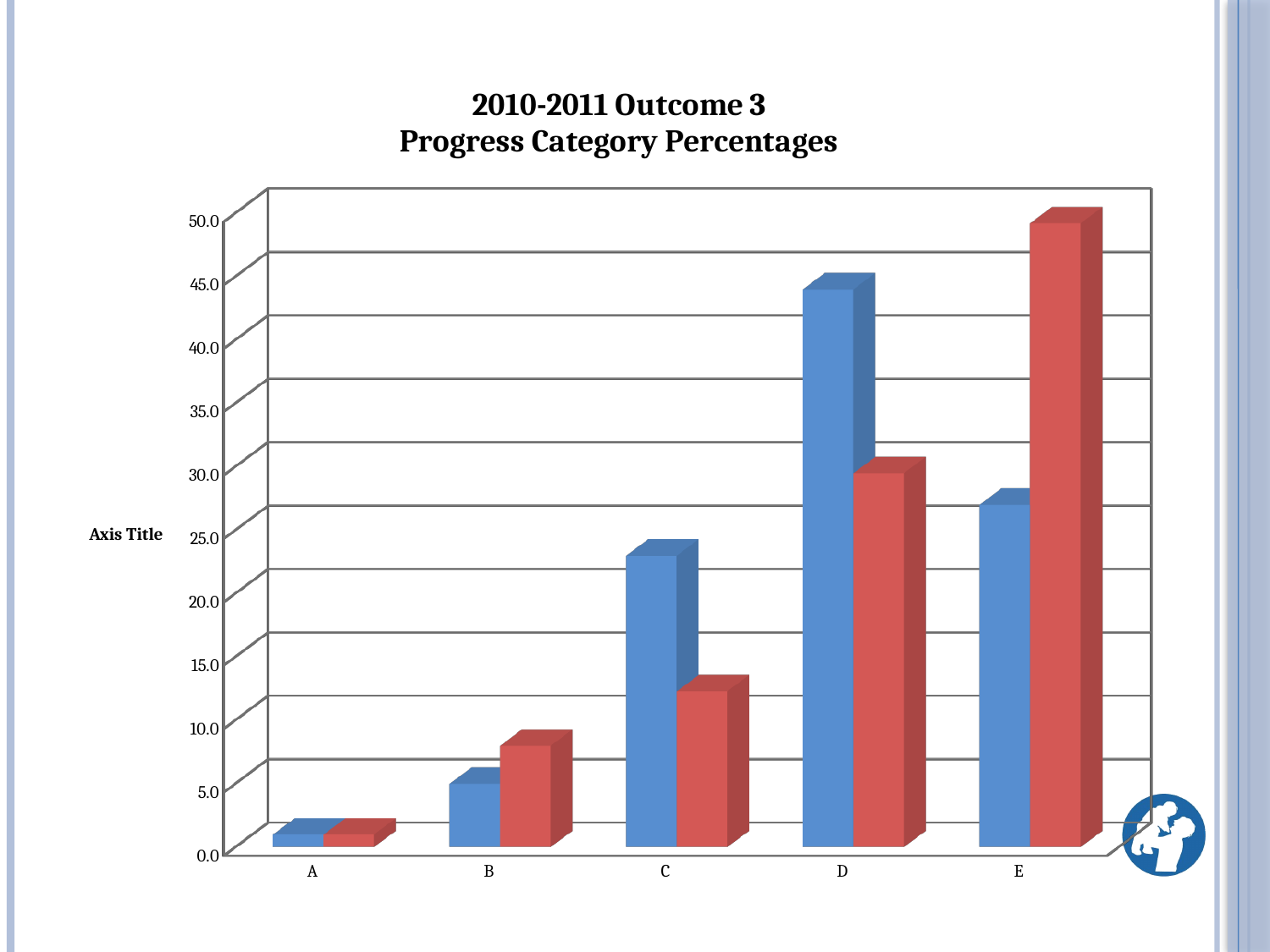
For category C, which bar is taller, the blue one or the red one? blue How many categories are shown on the x axis? 5 For category E, which bar is taller, the blue one or the red one? red Do the red bars rise or fall from category A to category E? rise Is the value of the red bar for E greater or less than 45.0? greater Is the value of the red bar for B greater or less than 10.0? less What is the title of the chart? 2010-2011 Outcome 3 Progress Category Percentages Which category has the highest red bar? E What kind of chart is shown on the slide? bar chart Is the value of the blue bar for D greater or less than 40.0? greater Which category has the lowest red bar? A Which category has the highest blue bar? D